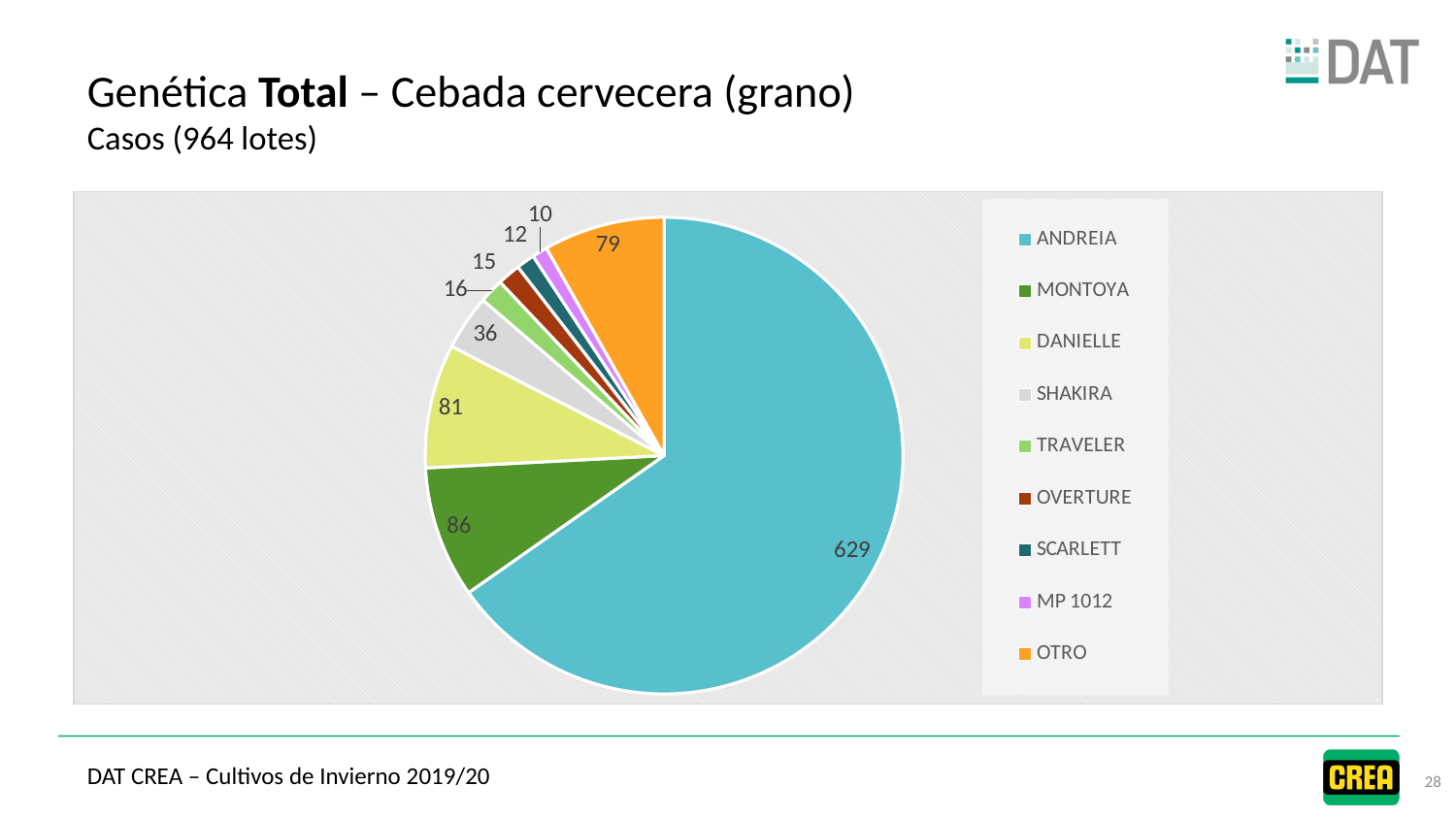
How many slices does the pie chart have? 9 Which is larger, the value for TRAVELER or the value for OVERTURE? TRAVELER What is the value shown for MONTOYA? 86 Which variety has the largest slice of the pie? ANDREIA How many lots are attributed to ANDREIA in the pie chart? 629 Which variety has the smallest slice of the pie? MP 1012 How many entries are listed in the legend? 9 What is the difference between the values for MONTOYA and DANIELLE? 5 What is the value shown for SHAKIRA? 36 What is the value shown for the OTRO slice? 79 What type of chart is shown on the slide? pie chart What is the difference between the values for ANDREIA and OTRO? 550